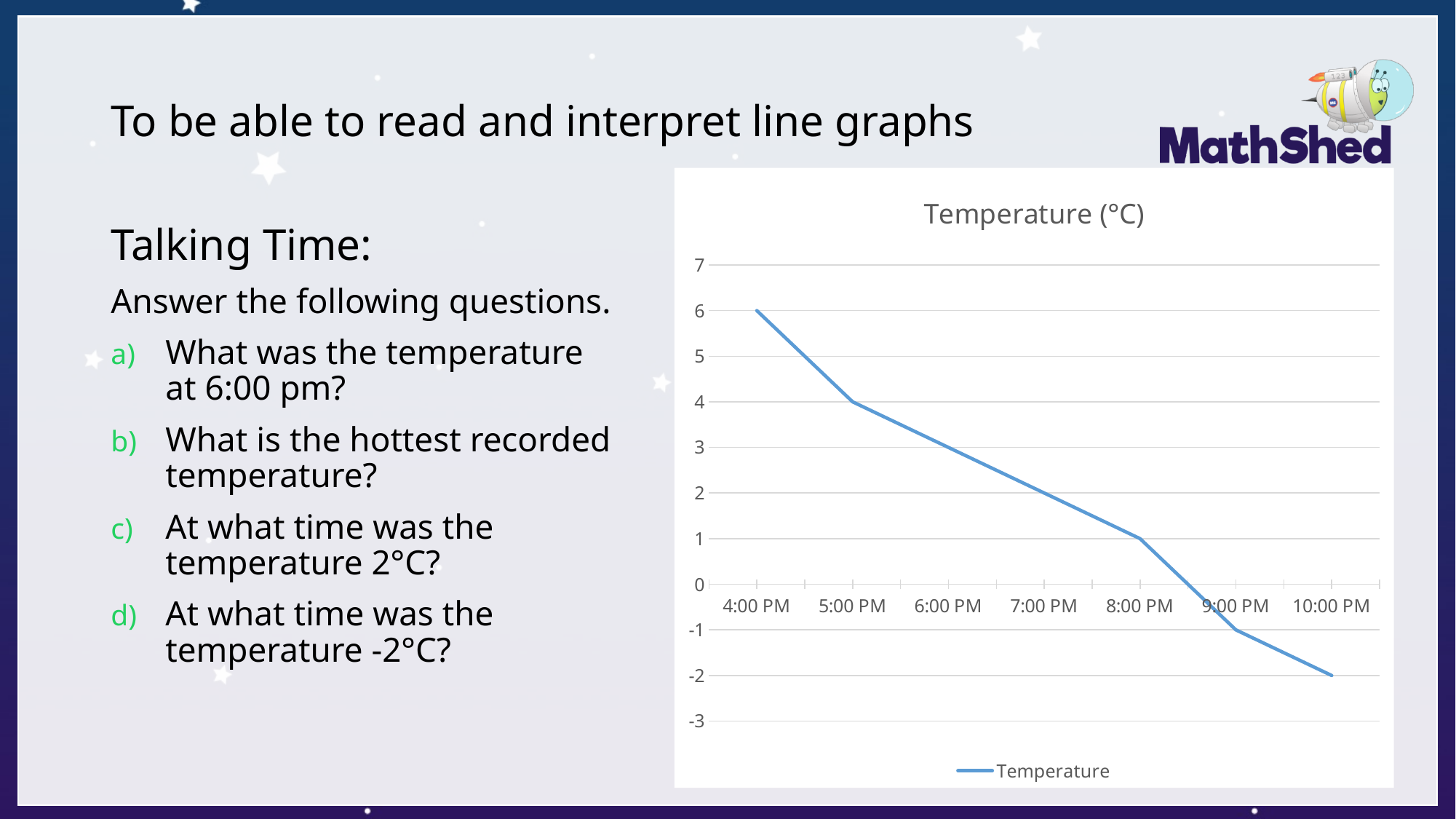
What is the difference between the temperature at 4:00 PM and the temperature at 5:00 PM? 2 What kind of chart is shown on the slide? line chart How many time points are plotted on the line? 7 What was the temperature at 6:00 PM? 3 At what time was the highest temperature recorded? 4:00 PM At what time was the temperature 2°C? 7:00 PM What was the temperature at 8:00 PM? 1 Does the temperature rise or fall from 4:00 PM to 10:00 PM? fall What was the temperature at 10:00 PM? -2 Which is higher, the temperature at 5:00 PM or the temperature at 9:00 PM? 5:00 PM At what time was the lowest temperature recorded? 10:00 PM What was the temperature at 4:00 PM? 6